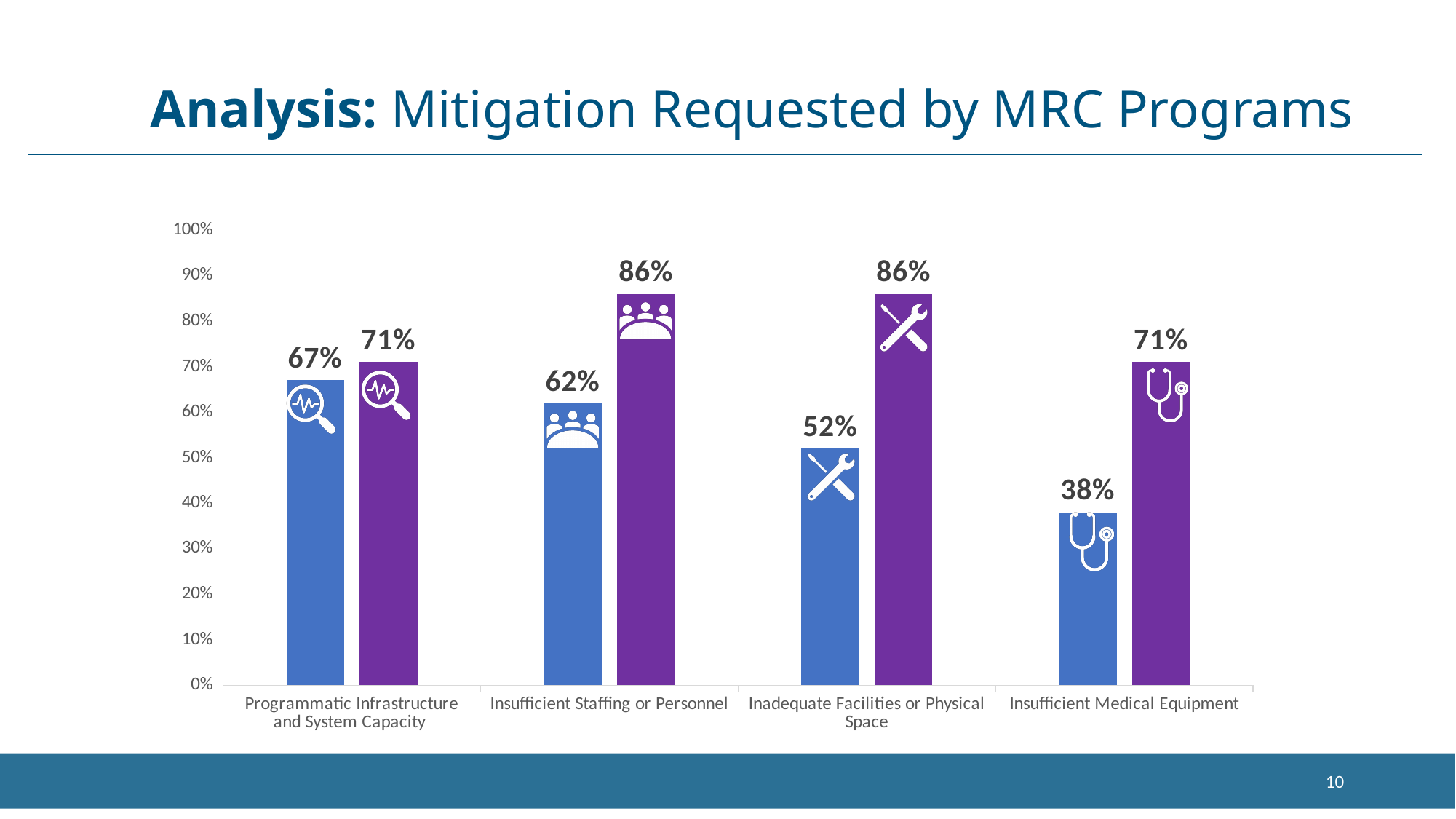
Which category has the highest blue bar? Programmatic Infrastructure and System Capacity Is the blue bar for Inadequate Facilities or Physical Space greater or less than 50%? greater What is the value of the blue bar for Insufficient Medical Equipment? 38% What is the value of the blue bar for Programmatic Infrastructure and System Capacity? 67% Which is larger: the blue bar for Insufficient Staffing or Personnel or the blue bar for Inadequate Facilities or Physical Space? Insufficient Staffing or Personnel How many categories are shown on the x axis? 4 What is the difference between the purple and blue bars for Inadequate Facilities or Physical Space? 34% Which category has the lowest blue bar? Insufficient Medical Equipment What is the value of the purple bar for Insufficient Staffing or Personnel? 86% What is the value of the purple bar for Insufficient Medical Equipment? 71% What is the difference between the purple and blue bars for Insufficient Medical Equipment? 33% What type of chart is shown on the slide? Bar chart